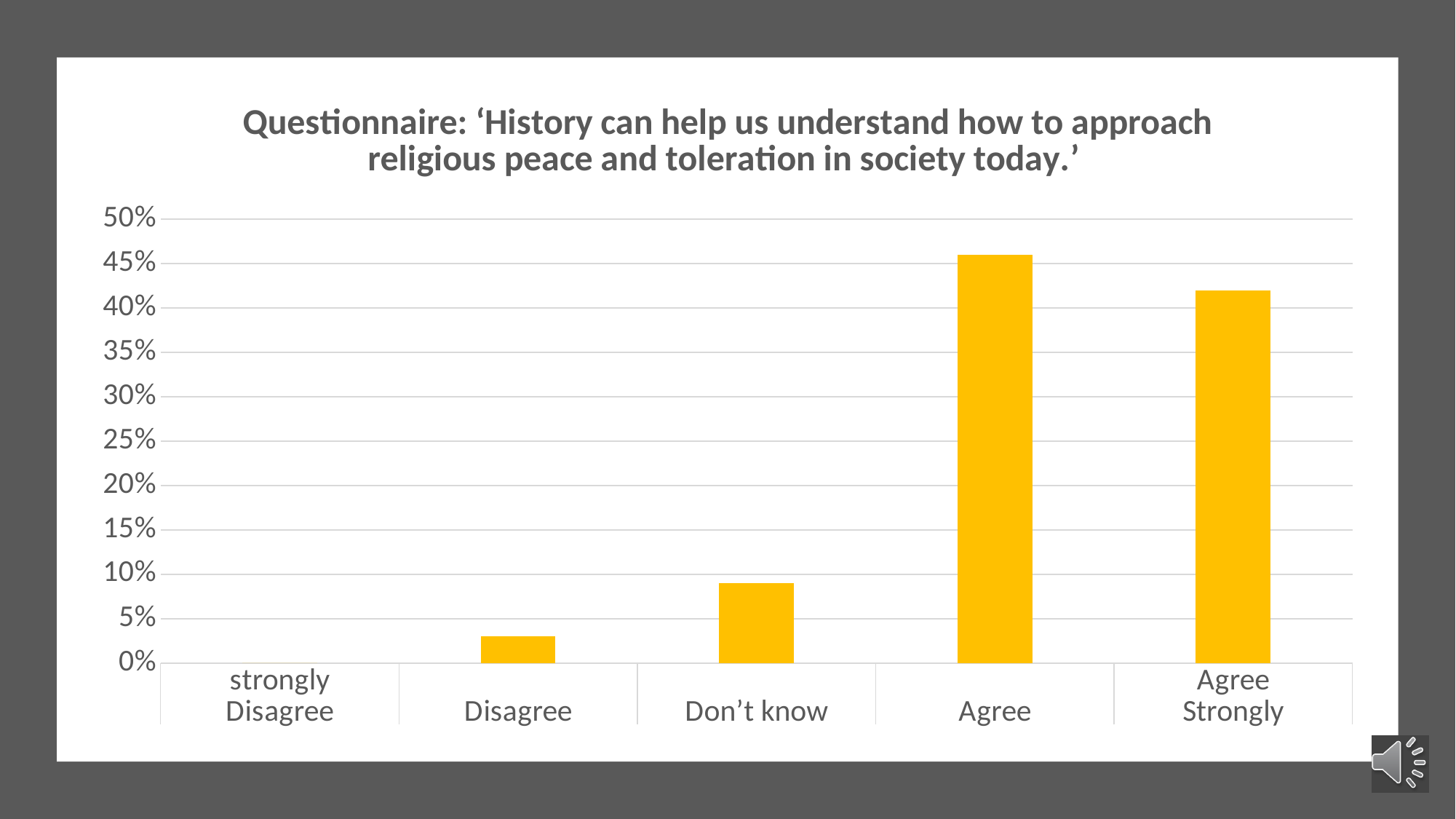
Is the value for Agree Strongly greater or less than 45%? less What kind of chart is shown on the slide? bar chart What is the highest value shown on the y axis? 50% Is the value for Don't know greater or less than 10%? less What colour are the bars in the chart? yellow Is the value for Disagree greater or less than 5%? less Which is larger, the value for Agree or the value for Don't know? Agree Which response category has the highest value? Agree Which response category has the lowest value? strongly Disagree Which is larger, the value for Disagree or the value for Don't know? Don't know How many response categories are shown on the x axis? 5